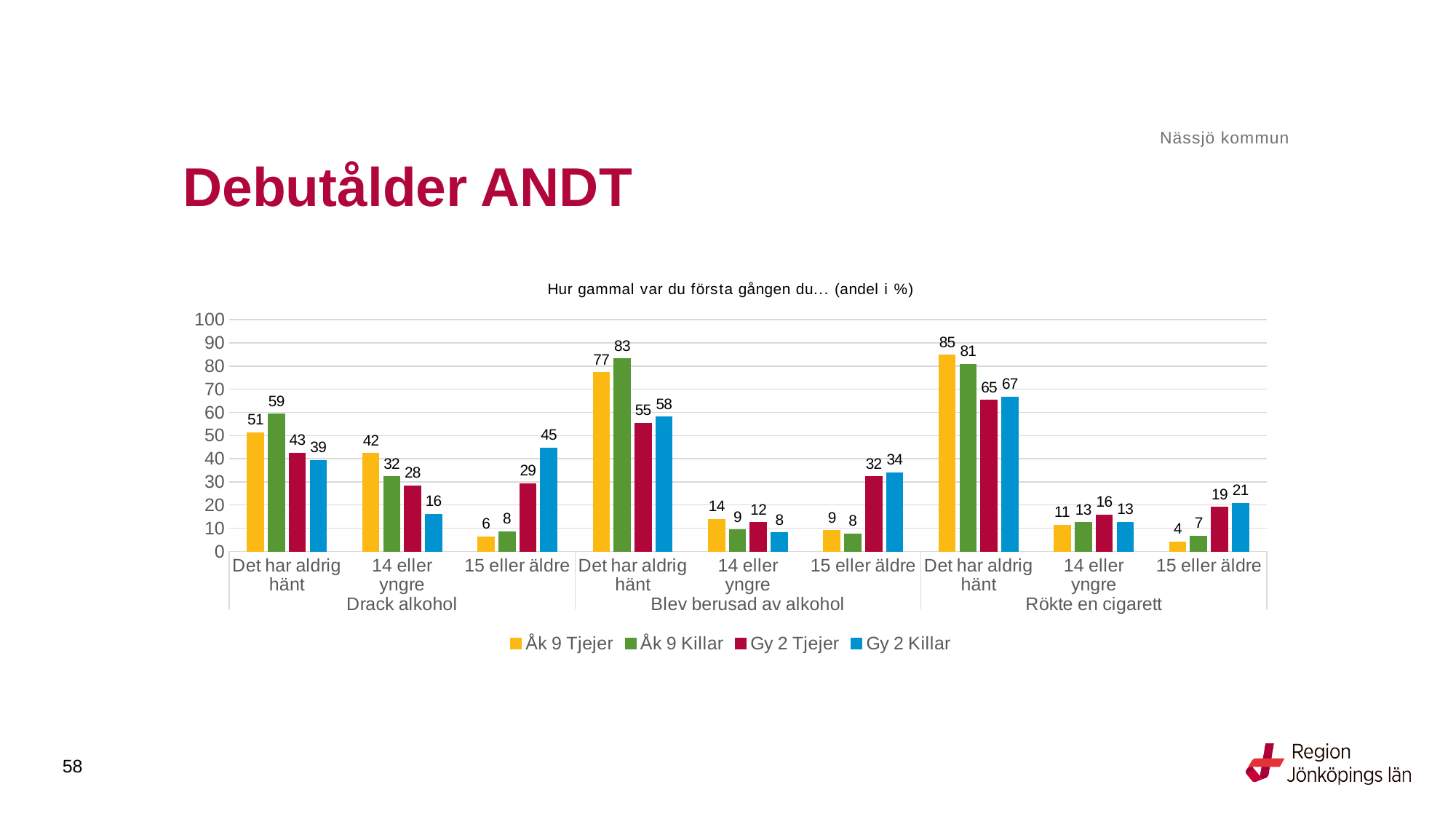
What is the value for Åk 9 Tjejer in the 'Det har aldrig hänt' category under 'Drack alkohol'? 51 What is the title of the chart? Hur gammal var du första gången du… (andel i %) What kind of chart is shown on the slide? Bar chart What is the value for Gy 2 Killar in the '15 eller äldre' category under 'Blev berusad av alkohol'? 34 How many category groups (questions) are shown along the x axis? 3 What is the difference between Åk 9 Killar and Gy 2 Tjejer in the 'Det har aldrig hänt' category under 'Blev berusad av alkohol'? 28 What is the value for Gy 2 Tjejer in the '14 eller yngre' category under 'Rökte en cigarett'? 16 Which is larger: Gy 2 Killar in '15 eller äldre' under 'Drack alkohol' or Åk 9 Tjejer in '14 eller yngre' under 'Drack alkohol'? Gy 2 Killar in '15 eller äldre' How many series does the legend list? 4 Is the value for Åk 9 Killar in the 'Det har aldrig hänt' category under 'Blev berusad av alkohol' greater or less than 80? greater Which series has the highest value in the 'Det har aldrig hänt' category under 'Rökte en cigarett'? Åk 9 Tjejer Which series has the lowest value in the '15 eller äldre' category under 'Drack alkohol'? Åk 9 Tjejer